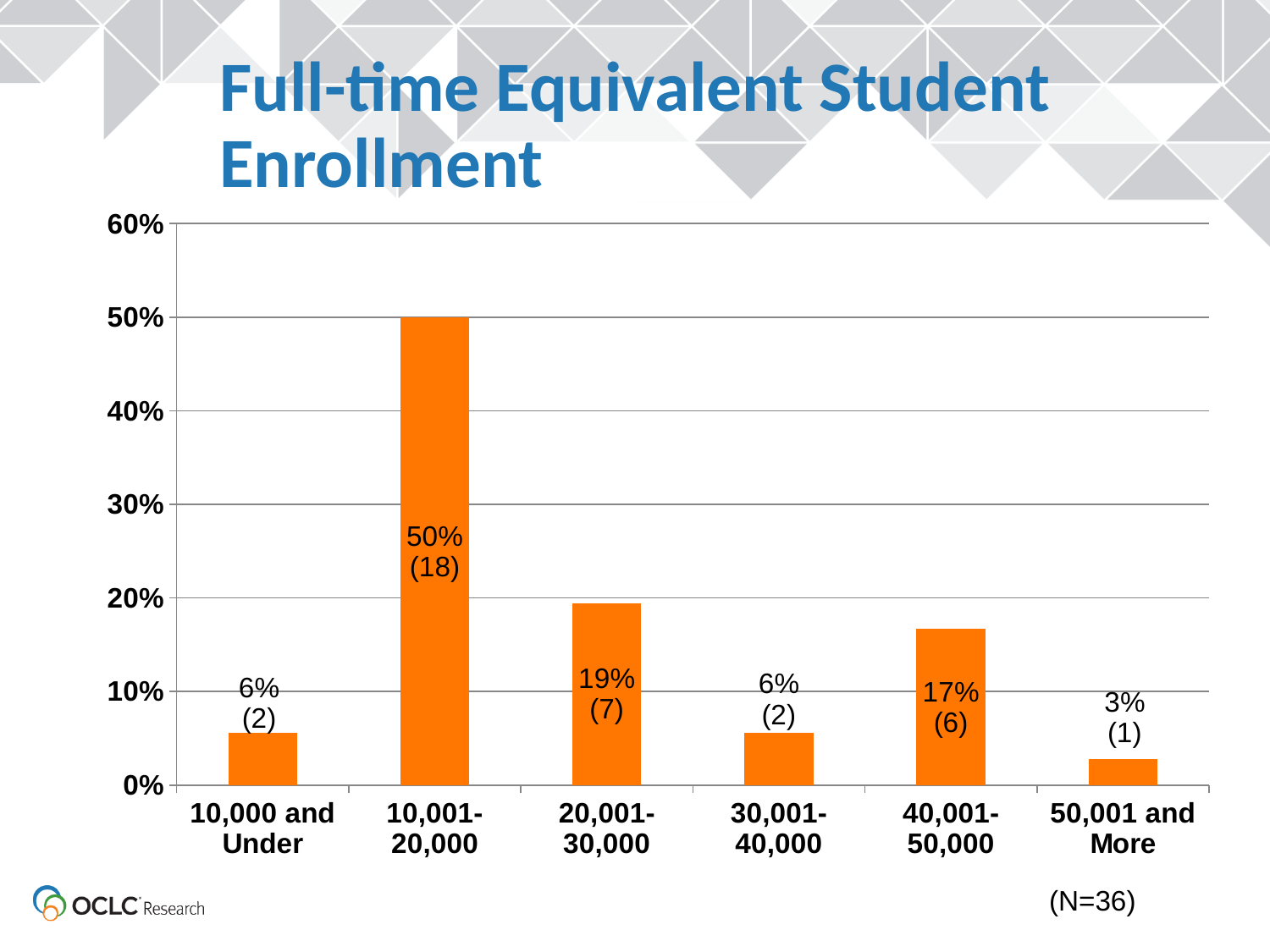
What is the title of the slide? Full-time Equivalent Student Enrollment What is the difference in percentage points between the 10,001-20,000 and 20,001-30,000 categories? 31 What percentage is shown for the 50,001 and More category? 3% What percentage is shown for the 10,001-20,000 category? 50% Which has a larger percentage, 40,001-50,000 or 30,001-40,000? 40,001-50,000 How many enrollment categories are shown on the x axis? 6 Which enrollment category has the highest percentage? 10,001-20,000 What kind of chart is shown on the slide? bar chart How many respondents are in the 20,001-30,000 category? 7 Which enrollment category has the lowest percentage? 50,001 and More Is the value for 40,001-50,000 greater or less than 20%? less What is the total number of respondents (N) noted on the slide? 36